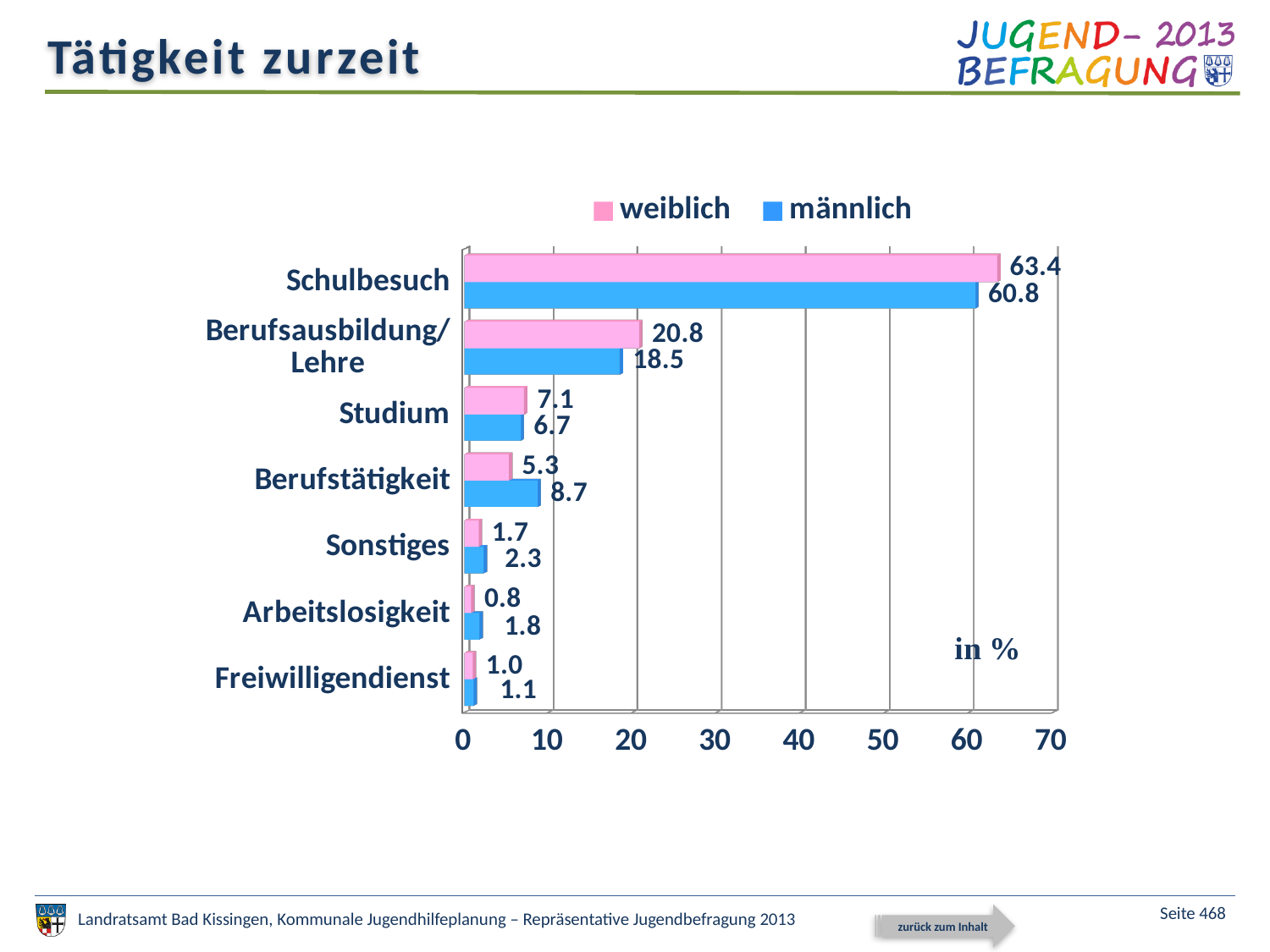
How many categories are shown on the chart? 7 What is the difference between the weiblich and männlich values for Schulbesuch? 2.6 Which category has the lowest value for weiblich? Arbeitslosigkeit Which category has the highest value for männlich? Schulbesuch Which colour represents the series weiblich? pink What is the value for weiblich for Arbeitslosigkeit? 0.8 What is the value for männlich for Berufstätigkeit? 8.7 What is the value for weiblich for Schulbesuch? 63.4 What is the value for männlich for Berufsausbildung/Lehre? 18.5 What kind of chart is shown on the slide? bar chart For Berufstätigkeit, which series has the larger value, weiblich or männlich? männlich How many series does the legend list? 2